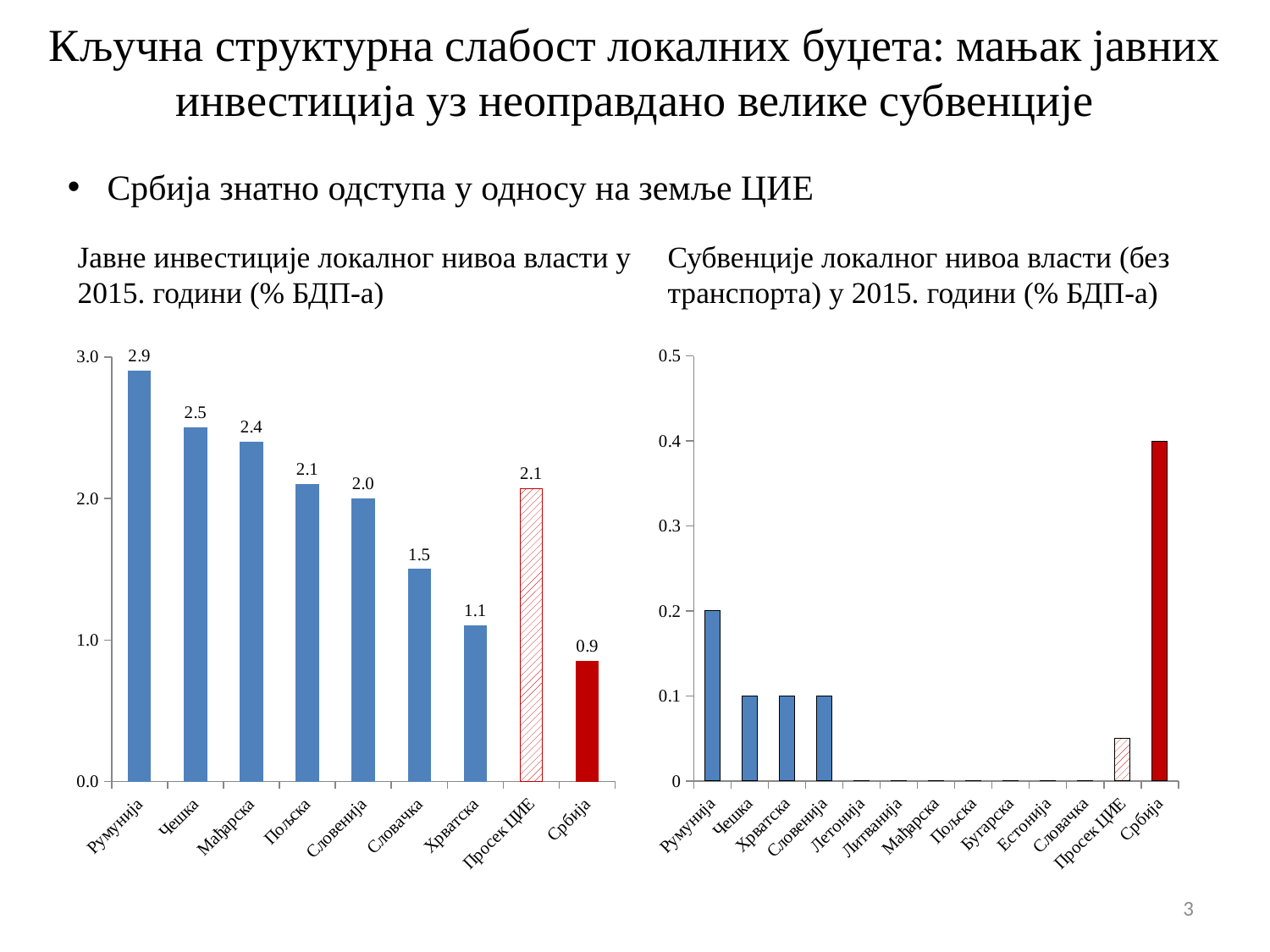
In the left chart (Јавне инвестиције локалног нивоа власти у 2015. години), which is larger, Чешка or Мађарска? Чешка In the right chart (Субвенције локалног нивоа власти (без транспорта) у 2015. години), is the value for Србија greater or less than 0.3? greater In the left chart (Јавне инвестиције локалног нивоа власти у 2015. години), which category has the lowest value? Србија In the left chart (Јавне инвестиције локалног нивоа власти у 2015. години), what is the value for Просек ЦИЕ? 2.1 In the left chart (Јавне инвестиције локалног нивоа власти у 2015. години), what is the value for Србија? 0.9 In the left chart (Јавне инвестиције локалног нивоа власти у 2015. години), what is the value for Румунија? 2.9 How many categories are shown in the left chart (Јавне инвестиције локалног нивоа власти у 2015. години)? 9 What kind of chart is the right chart (Субвенције локалног нивоа власти (без транспорта) у 2015. години)? bar chart How many categories are shown in the right chart (Субвенције локалног нивоа власти (без транспорта) у 2015. години)? 13 In the left chart (Јавне инвестиције локалног нивоа власти у 2015. години), what is the difference between Просек ЦИЕ and Србија? 1.2 In the right chart (Субвенције локалног нивоа власти (без транспорта) у 2015. години), which category has the highest value? Србија In the left chart (Јавне инвестиције локалног нивоа власти у 2015. години), which country has the highest value? Румунија